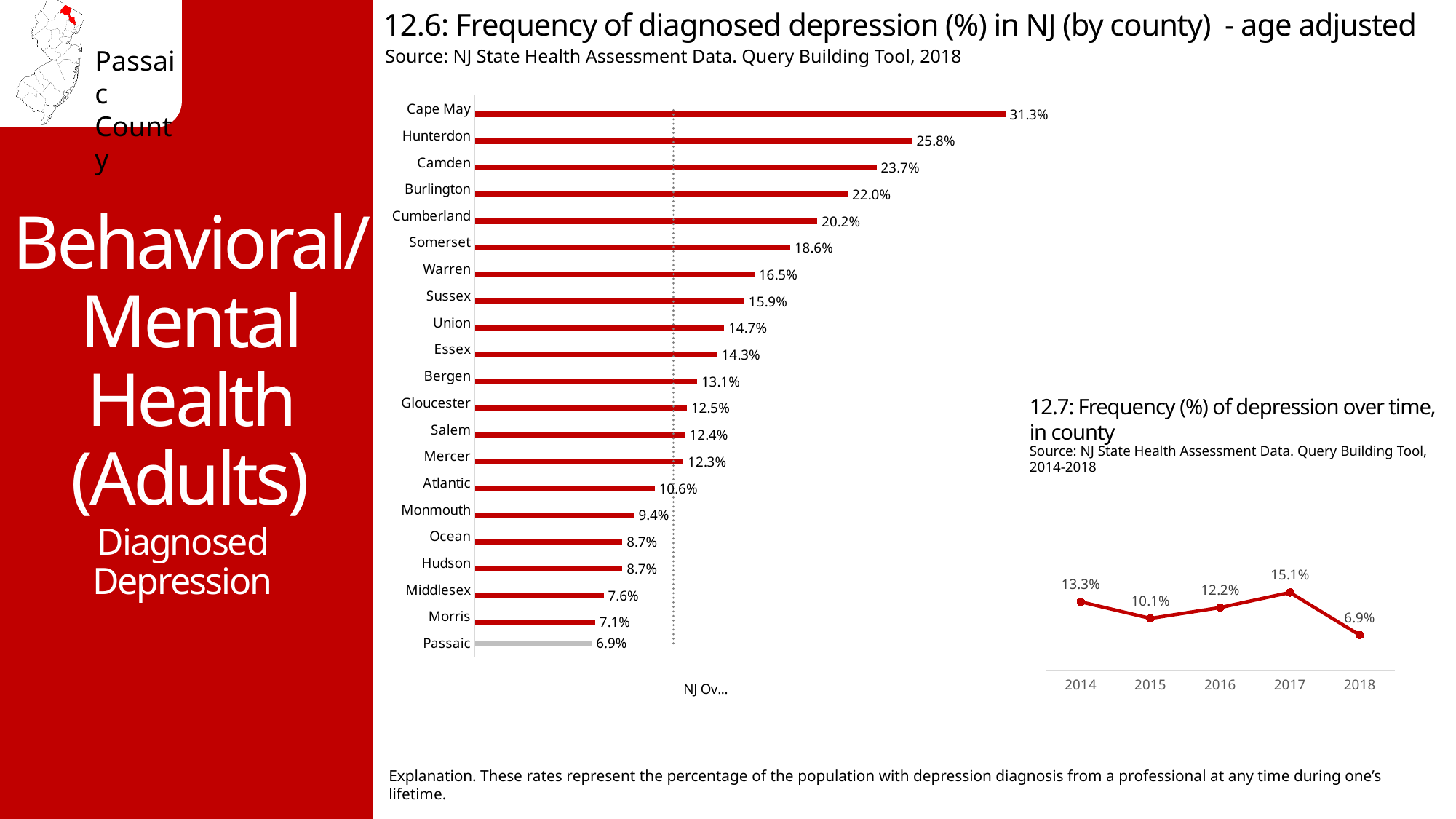
In chart 12.7 (Frequency of depression over time, in county), what is the value for 2017? 15.1% What kind of chart is chart 12.7 (Frequency of depression over time, in county)? Line chart In chart 12.6 (Frequency of diagnosed depression by county), which county has the lowest value? Passaic In chart 12.6 (Frequency of diagnosed depression by county), which is larger, Bergen or Atlantic? Bergen In chart 12.7 (Frequency of depression over time, in county), which year has the lowest value? 2018 In chart 12.6 (Frequency of diagnosed depression by county), how many counties are shown? 21 In chart 12.6 (Frequency of diagnosed depression by county), what is the difference between Hunterdon and Camden? 2.1% In chart 12.6 (Frequency of diagnosed depression by county), what is the value for Cape May? 31.3% What kind of chart is chart 12.6 (Frequency of diagnosed depression by county)? Bar chart In chart 12.7 (Frequency of depression over time, in county), what is the difference between 2017 and 2018? 8.2% In chart 12.6 (Frequency of diagnosed depression by county), what is the value for Passaic? 6.9% In chart 12.6 (Frequency of diagnosed depression by county), which county has the highest value? Cape May